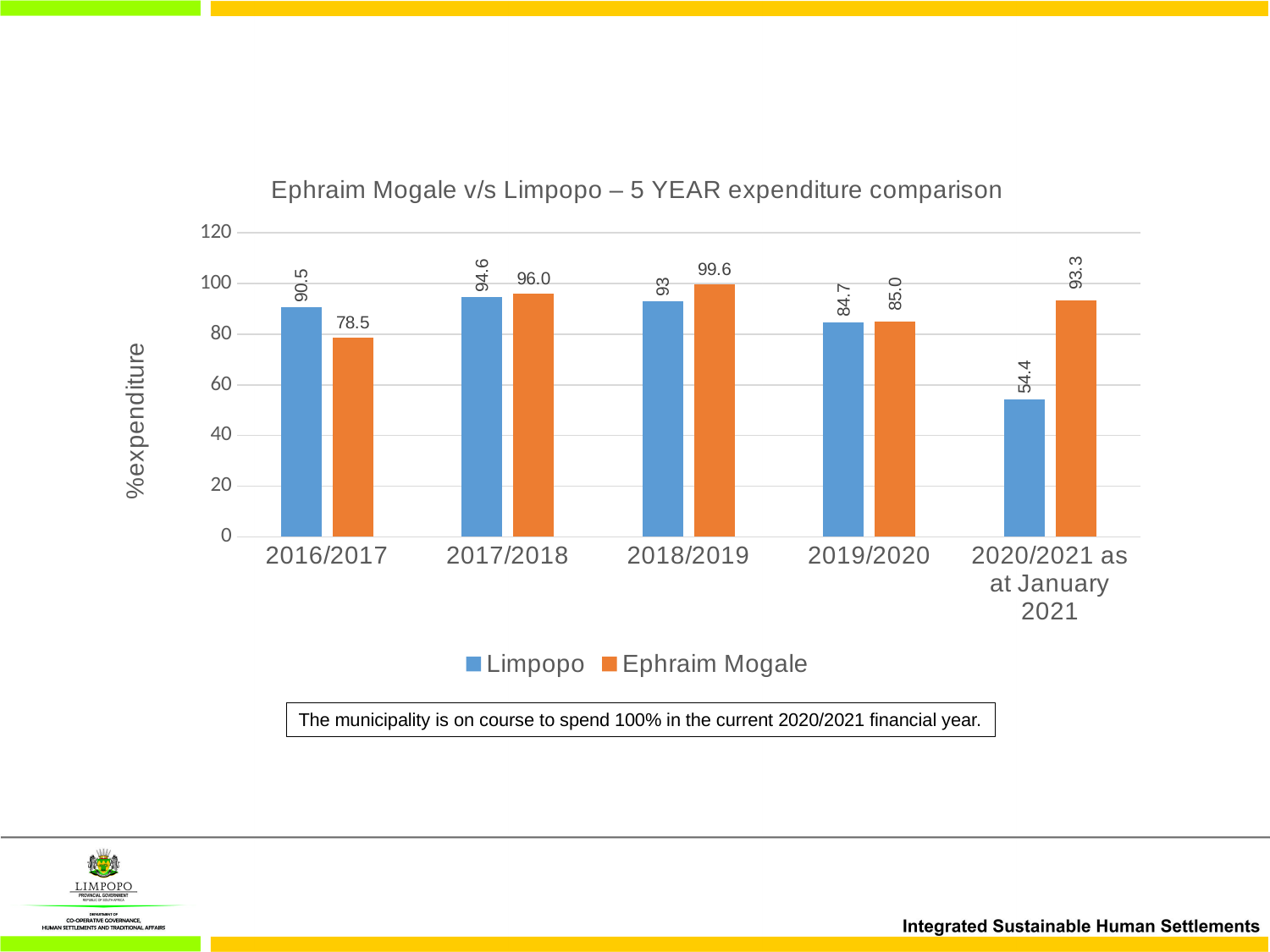
What kind of chart is shown? bar chart Which year has the lowest Limpopo value? 2020/2021 as at January 2021 What is the Limpopo value for 2016/2017? 90.5 What is the Limpopo value for 2020/2021 as at January 2021? 54.4 How many years are shown on the x axis? 5 Which year has the highest Ephraim Mogale value? 2018/2019 How many series does the legend list? 2 What is the title of the chart? Ephraim Mogale v/s Limpopo – 5 YEAR expenditure comparison What is the difference between the Ephraim Mogale and Limpopo values in 2020/2021 as at January 2021? 38.9 In 2016/2017, which series has the larger value, Limpopo or Ephraim Mogale? Limpopo What is the Ephraim Mogale value for 2018/2019? 99.6 Is the Limpopo value for 2019/2020 greater or less than 80? greater